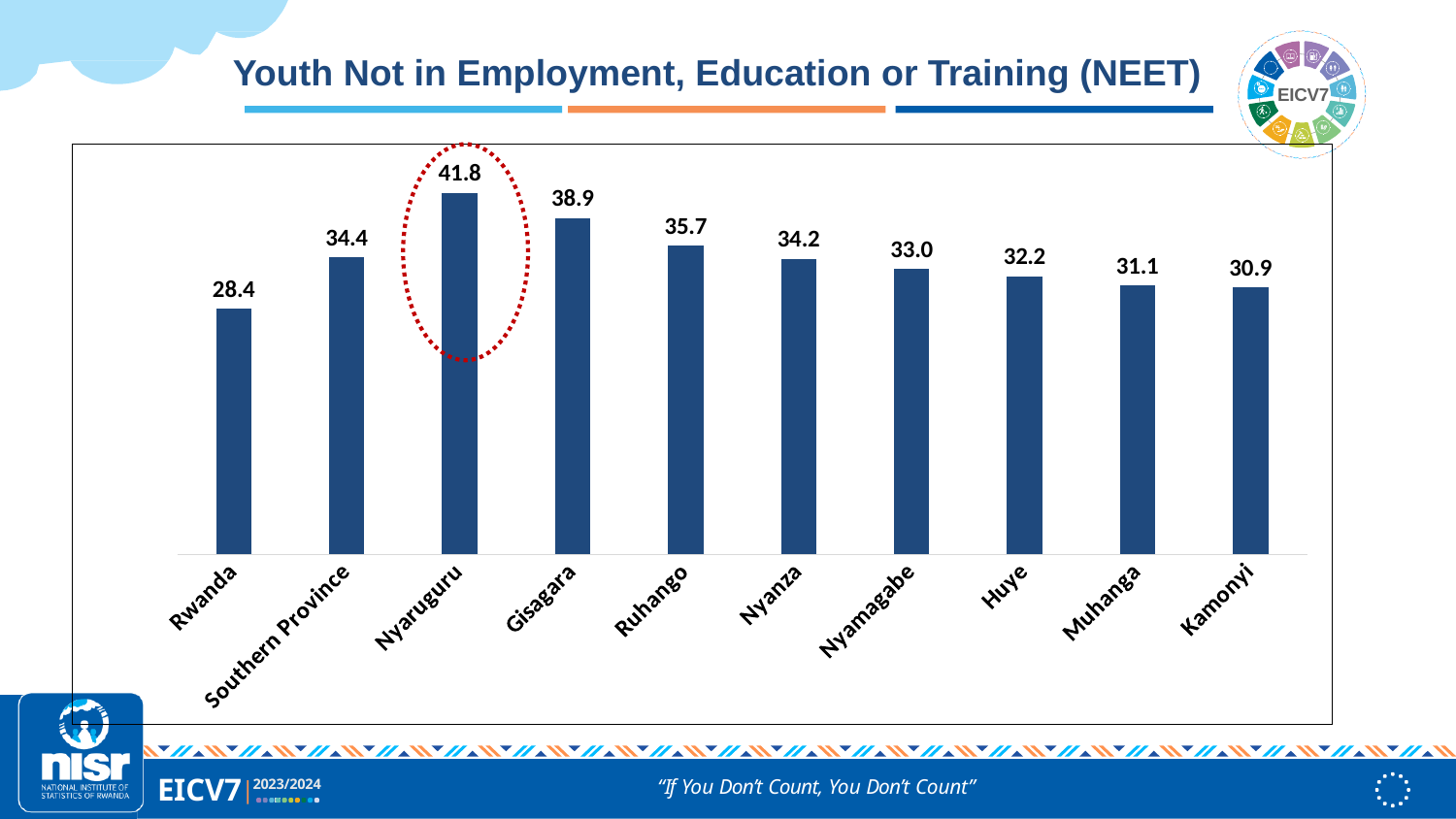
What kind of chart is shown on the slide? Bar chart What is the NEET value for Nyaruguru? 41.8 Which category has the lowest NEET value? Rwanda What is the NEET value for Rwanda? 28.4 How many categories are shown on the x axis? 10 What is the NEET value for Kamonyi? 30.9 What is the difference between the NEET values for Gisagara and Huye? 6.7 What is the difference between the NEET values for Nyaruguru and Rwanda? 13.4 Which category has the highest NEET value? Nyaruguru What is the NEET value for Southern Province? 34.4 Which bar is highlighted with a red dotted circle? Nyaruguru Which has a higher NEET value, Ruhango or Nyamagabe? Ruhango